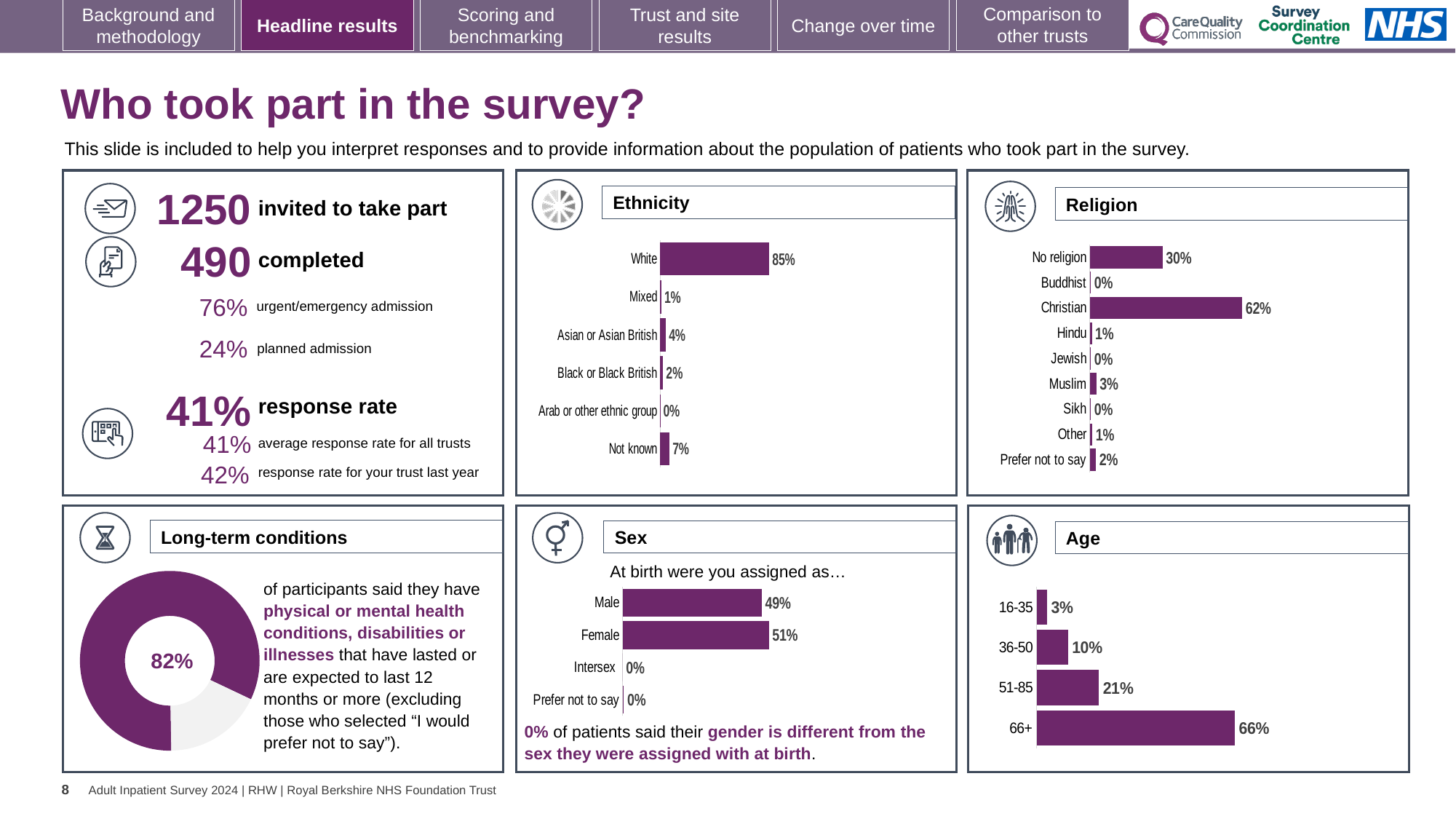
In the Age chart, what is the value for the 36-50 age group? 10% In the Sex chart, which is larger, Male or Female? Female In the Ethnicity chart, how many categories are shown? 6 In the Ethnicity chart, which category has the highest value? White In the Religion chart, what is the difference between the Christian and No religion values? 32% In the Religion chart, what percentage of respondents were Christian? 62% What kind of chart is the Long-term conditions chart? doughnut chart In the Age chart, do the values rise or fall as you move from 16-35 to 66+? rise In the Religion chart, how many categories are shown? 9 In the Sex chart, what percentage of respondents were Male? 49% In the Ethnicity chart, what percentage of respondents were White? 85% In the Age chart, which age group has the highest value? 66+